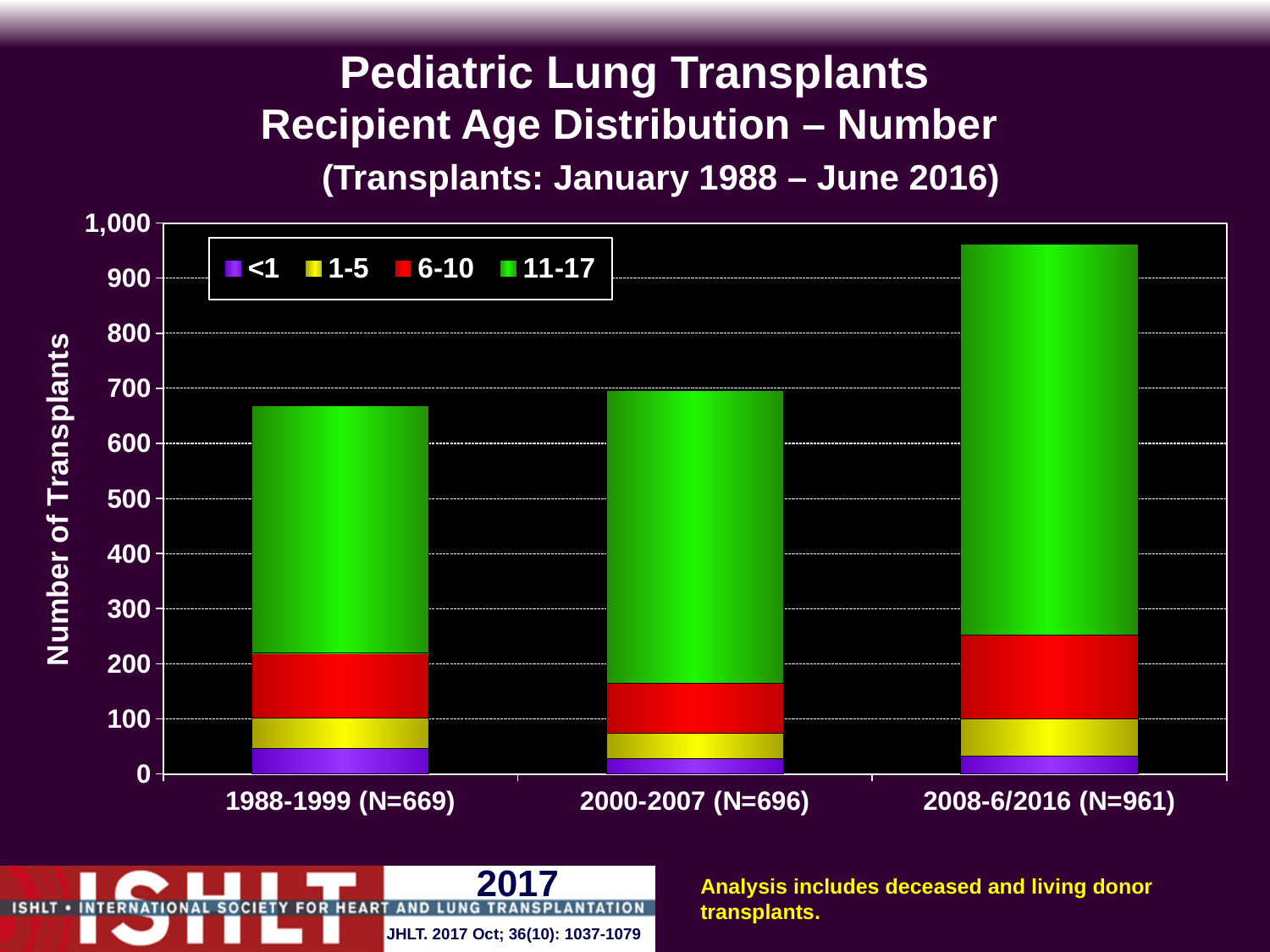
What is the total number of transplants (N) for the 2000-2007 period? 696 Which period has the highest total number of transplants? 2008-6/2016 (N=961) Is the top of the 6-10 age segment in the 2008-6/2016 bar greater or less than 200 on the y axis? greater What is the total number of transplants (N) for the 1988-1999 period? 669 Do the total numbers of transplants rise or fall across the periods from left to right? Rise Which age group is shown in green in the legend? 11-17 What kind of chart is shown on the slide? Stacked bar chart What is the total number of transplants (N) for the 2008-6/2016 period? 961 How many age groups does the legend list? 4 How many time-period categories are shown on the x axis? 3 Which period has the lowest total number of transplants? 1988-1999 (N=669) What is the difference in total transplants between the 2008-6/2016 period and the 1988-1999 period? 292